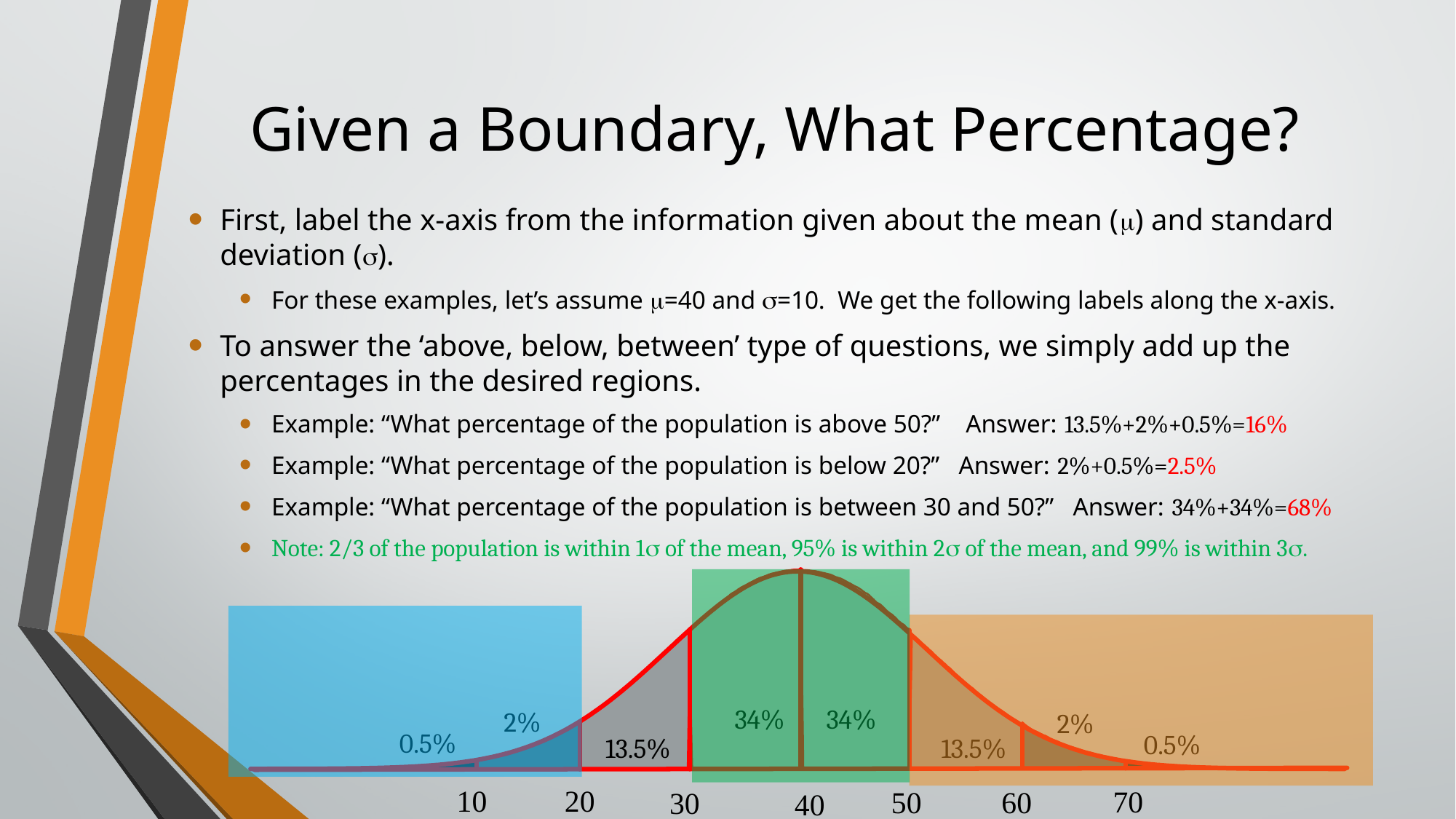
Which region of the curve has the largest percentage label? 34% (between 30 and 50, either side of 40) What colour is the shaded region covering the left side of the curve below 20? Blue Which is larger, the region between 50 and 60 or the region between 60 and 70? The region between 50 and 60 (13.5%) What is the difference between the 34% region and the 13.5% region? 20.5% What percentage label is shown for the region between 20 and 30? 13.5% What percentage of the population lies between 30 and 40 on the curve? 34% What x-axis value is at the center (peak) of the curve? 40 What percentage label is shown for the region beyond 70 on the right tail? 0.5% How many labeled tick values are shown on the x-axis? 7 What is the smallest percentage label shown on the curve? 0.5% What percentage label is shown for the region between 60 and 70? 2% What is the total percentage of the two green-shaded regions between 30 and 50? 68%